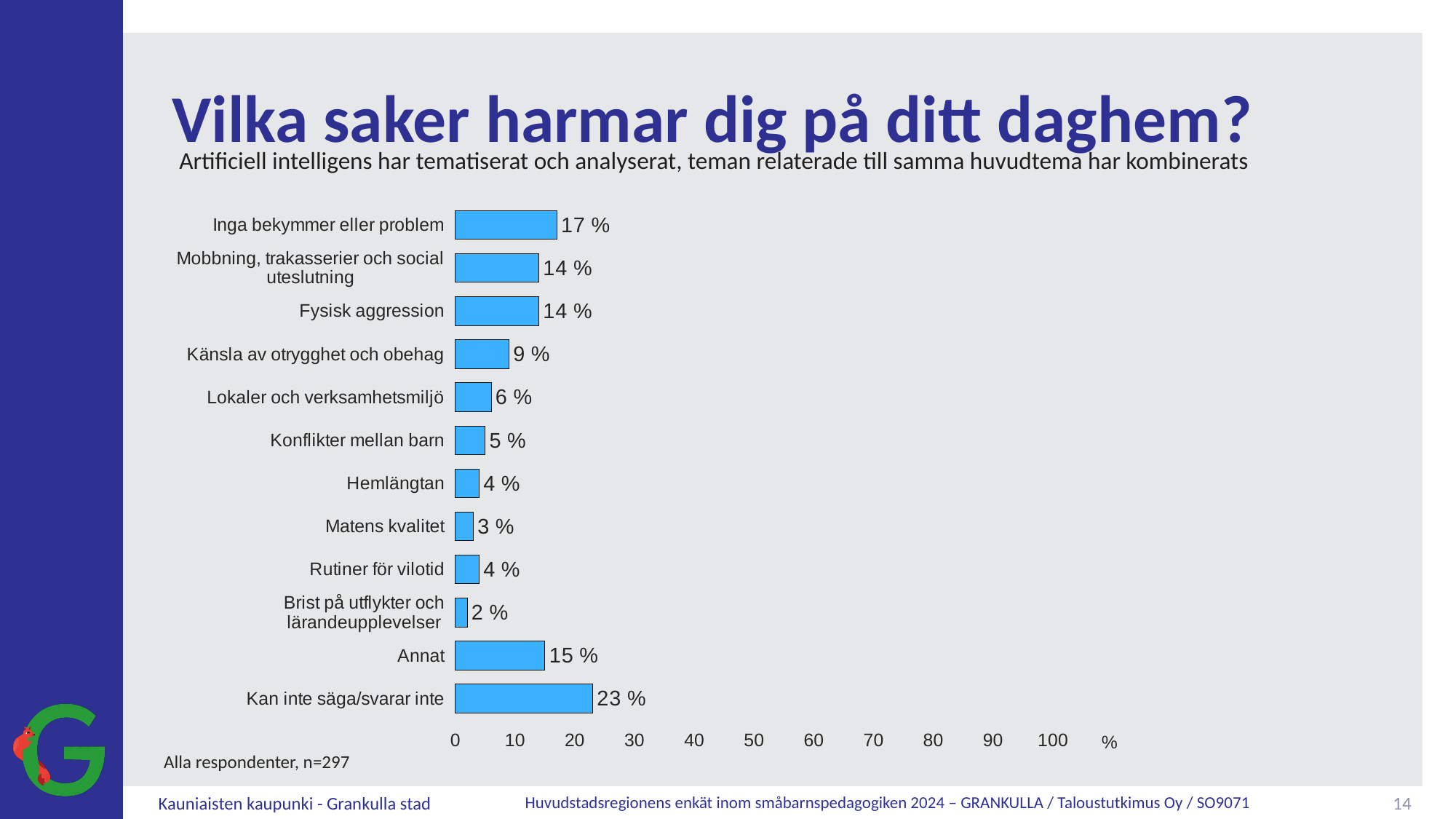
How many categories are shown in the chart? 12 Is the value for "Kan inte säga/svarar inte" greater or less than 20? greater What is the value for "Kan inte säga/svarar inte"? 23 % What is the value for "Fysisk aggression"? 14 % Which category has the highest value? Kan inte säga/svarar inte What is the value for "Inga bekymmer eller problem"? 17 % What is the value for "Brist på utflykter och lärandeupplevelser"? 2 % What is the difference between "Kan inte säga/svarar inte" and "Annat"? 8 % Which category has the lowest value? Brist på utflykter och lärandeupplevelser What is the title of the slide? Vilka saker harmar dig på ditt daghem? What kind of chart is shown on the slide? bar chart Which is larger, "Inga bekymmer eller problem" or "Annat"? Inga bekymmer eller problem